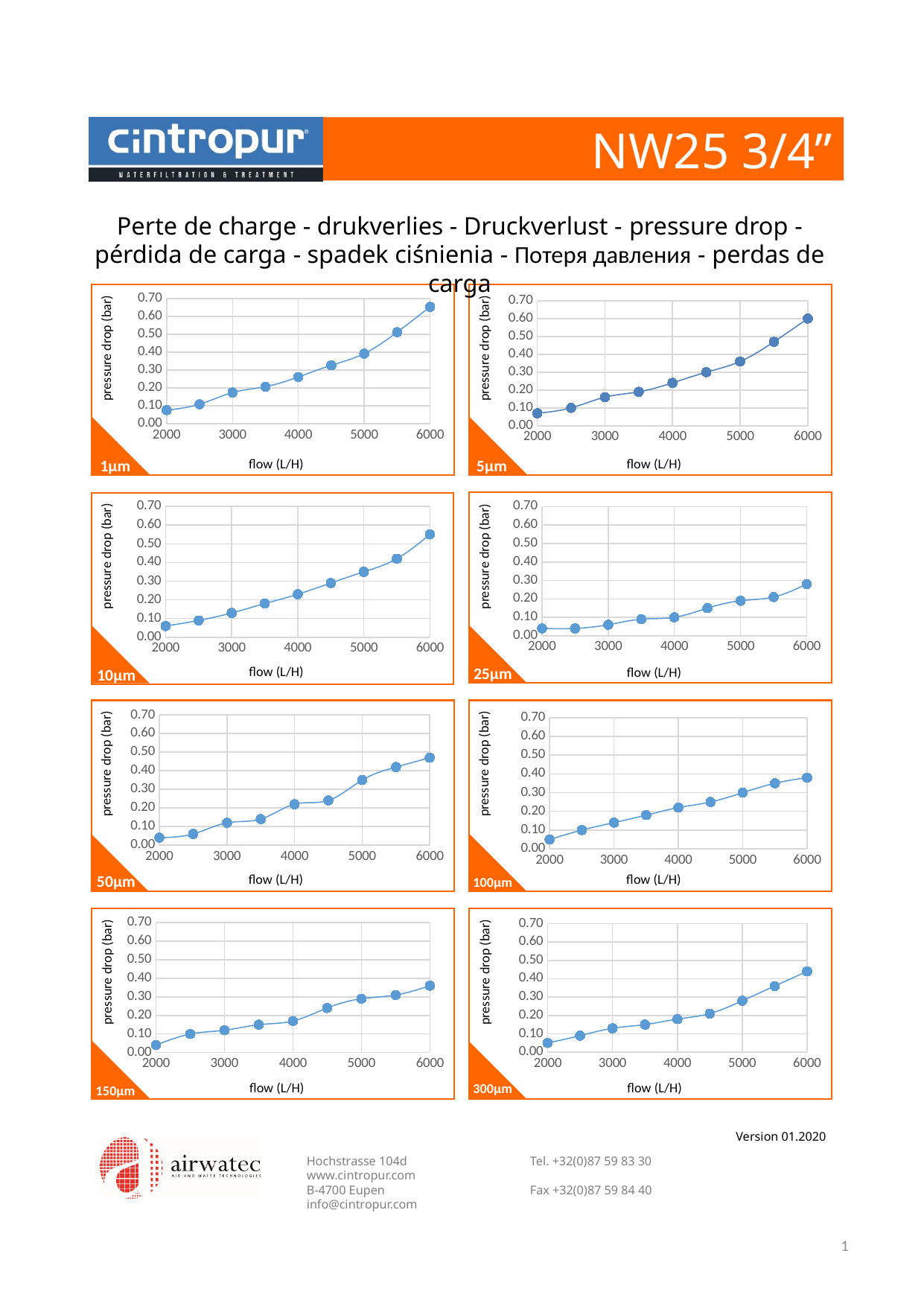
On the 150µm chart, at which flow value is the pressure drop highest? 6000 On the 10µm chart, is the pressure drop at 6000 L/H greater or less than 0.50? greater On the 300µm chart, is the pressure drop at 6000 L/H greater or less than 0.40? greater At 6000 L/H, which chart shows the larger pressure drop: the 1µm chart or the 25µm chart? 1µm How many data points are plotted on the 25µm chart? 9 What kind of chart is the 1µm chart? line chart On the 50µm chart, is the pressure drop at 2000 L/H greater or less than 0.10? less What is the label on the vertical axis of the 100µm chart? pressure drop (bar) How many charts are shown on the slide? 8 On the 1µm chart, does the pressure drop rise or fall as flow increases from 2000 to 6000 L/H? rise